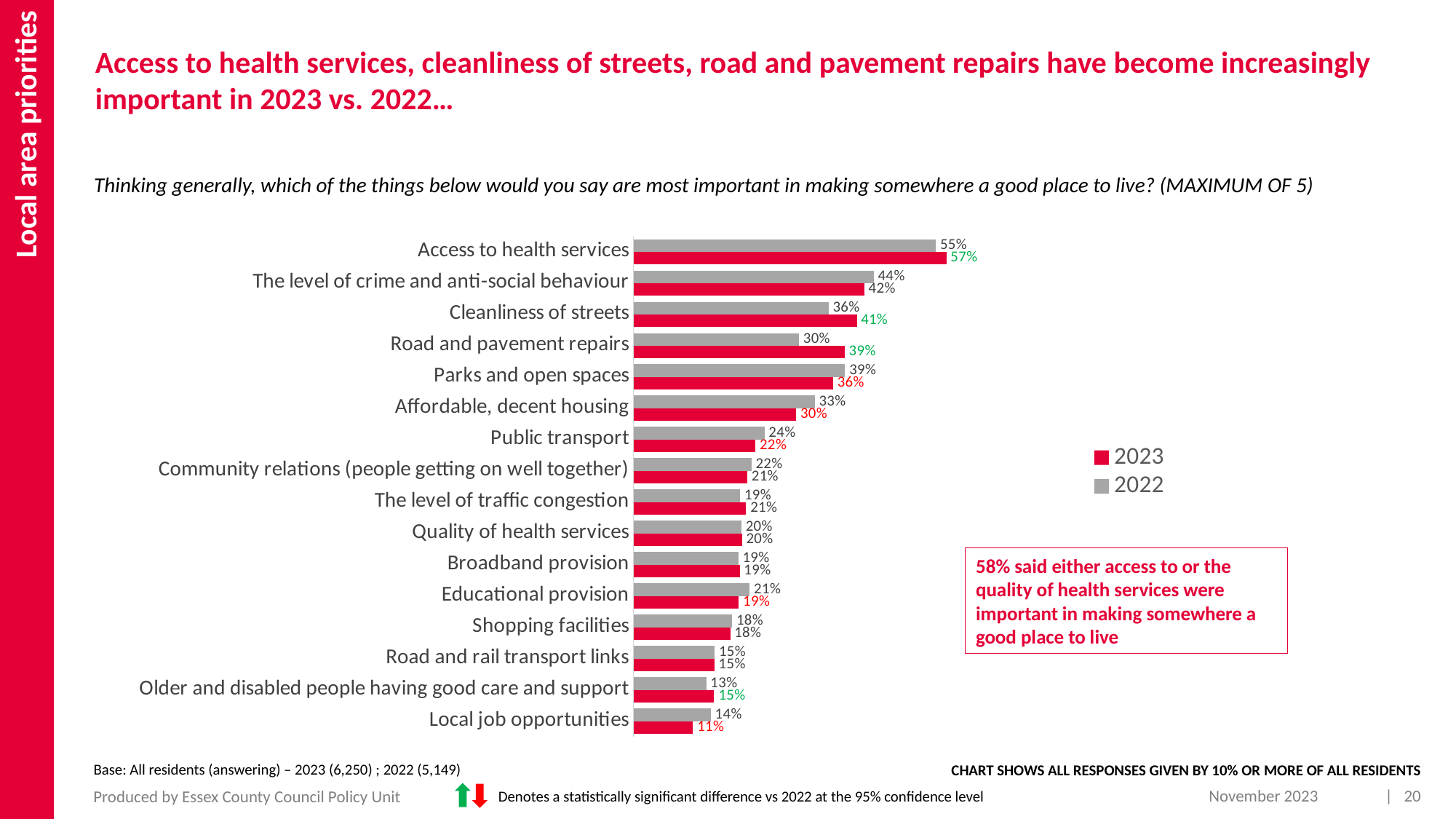
How many categories are shown in the chart? 16 Which is larger for Parks and open spaces: the 2023 value or the 2022 value? 2022 What is the difference between the 2023 and 2022 values for Road and pavement repairs? 9 percentage points Which category has the highest value for 2023? Access to health services Which category has the lowest value for 2023? Local job opportunities What was the 2022 value for Road and pavement repairs? 30% What type of chart is shown on the slide? Bar chart What is the difference between the 2022 and 2023 values for Local job opportunities? 3 percentage points How many series does the legend list? 2 What percentage of residents chose Access to health services in 2023? 57% What percentage chose Cleanliness of streets in 2023? 41% Which colour represents the 2022 series in the chart? Grey